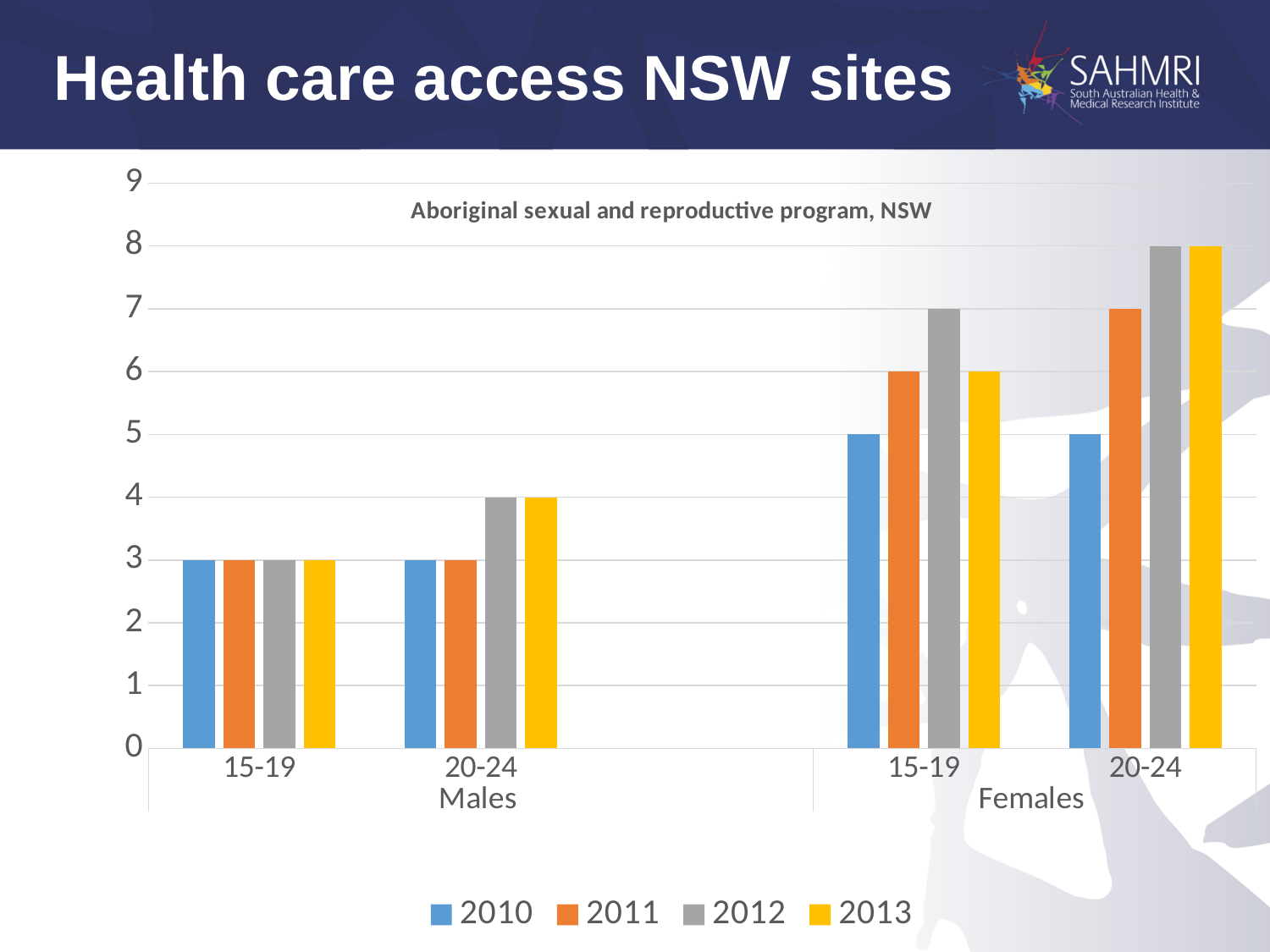
How many series does the legend list? 4 Which is larger: the 2011 value for Females 20-24 or the 2011 value for Females 15-19? Females 20-24 Which year has the lowest value for Females 20-24? 2010 Which year has the highest value for Females 15-19? 2012 What is the value for Males 15-19 in 2010? 3 What is the value for Females 15-19 in 2011? 6 What is the difference between the 2012 value for Females 20-24 and the 2012 value for Males 20-24? 4 What type of chart is shown on the slide? bar chart Is the value for Females 15-19 in 2012 greater or less than 6? greater What is the value for Males 20-24 in 2013? 4 What is the title of the chart? Aboriginal sexual and reproductive program, NSW What is the value for Females 20-24 in 2012? 8